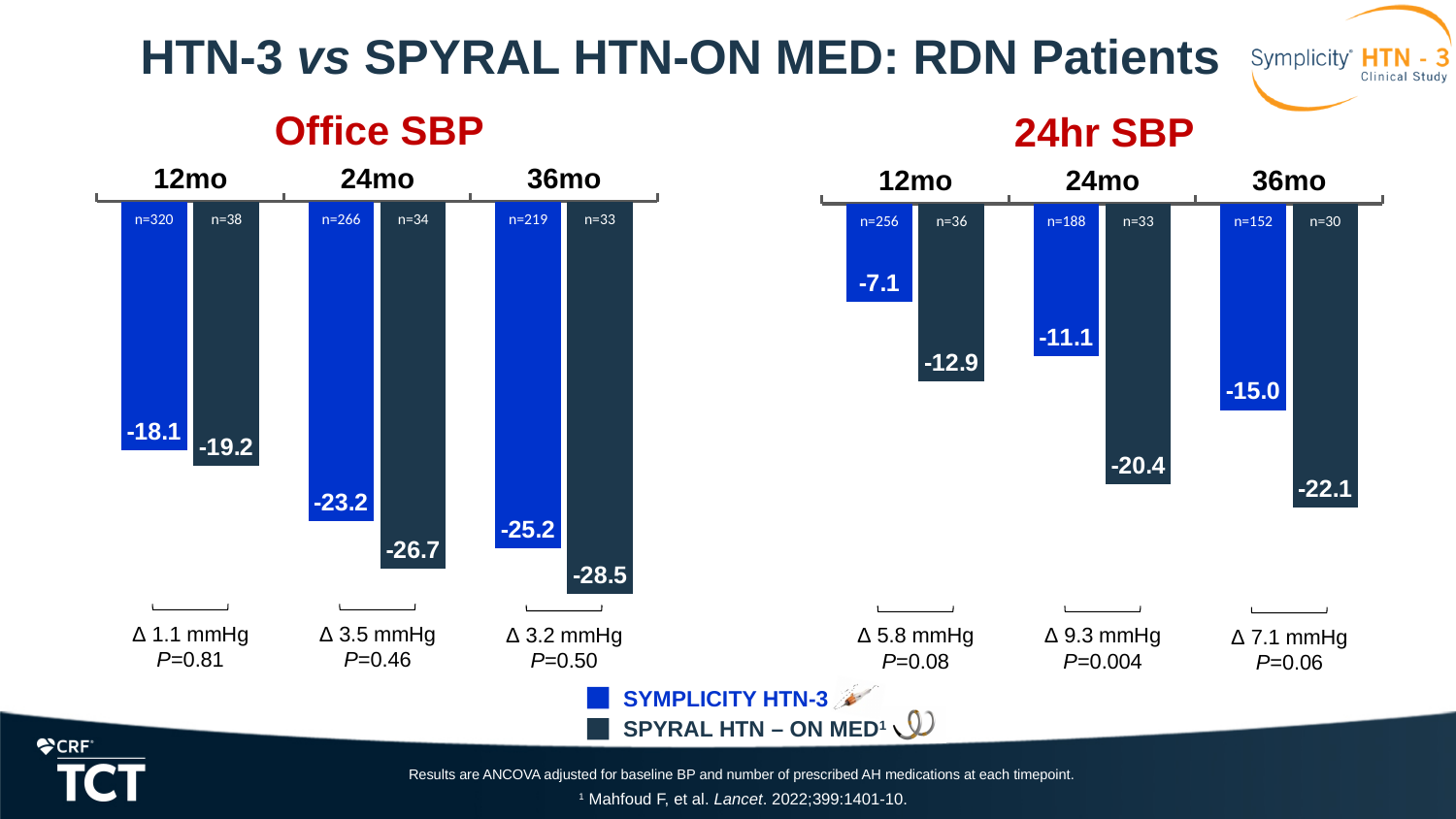
In the 24hr SBP chart, which bar shows the largest reduction (most negative value)? SPYRAL HTN – ON MED at 36mo In the 24hr SBP chart, what is the value for SYMPLICITY HTN-3 at 24mo? -11.1 In the Office SBP chart, what is the difference between the SPYRAL HTN – ON MED and SYMPLICITY HTN-3 values at 24mo? 3.5 In the 24hr SBP chart, what is the value for SPYRAL HTN – ON MED at 12mo? -12.9 In the 24hr SBP chart, which bar shows the smallest reduction (least negative value)? SYMPLICITY HTN-3 at 12mo In the Office SBP chart, do the SYMPLICITY HTN-3 values become more negative or less negative from 12mo to 36mo? More negative In the Office SBP chart, what is the value for SYMPLICITY HTN-3 at 12mo? -18.1 In the Office SBP chart, what is the value for SPYRAL HTN – ON MED at 36mo? -28.5 How many series does the legend list? 2 In the 24hr SBP chart, which series shows a larger reduction at 24mo, SYMPLICITY HTN-3 or SPYRAL HTN – ON MED? SPYRAL HTN – ON MED What kind of chart is the 24hr SBP chart? Bar chart How many timepoints are shown in the Office SBP chart? 3